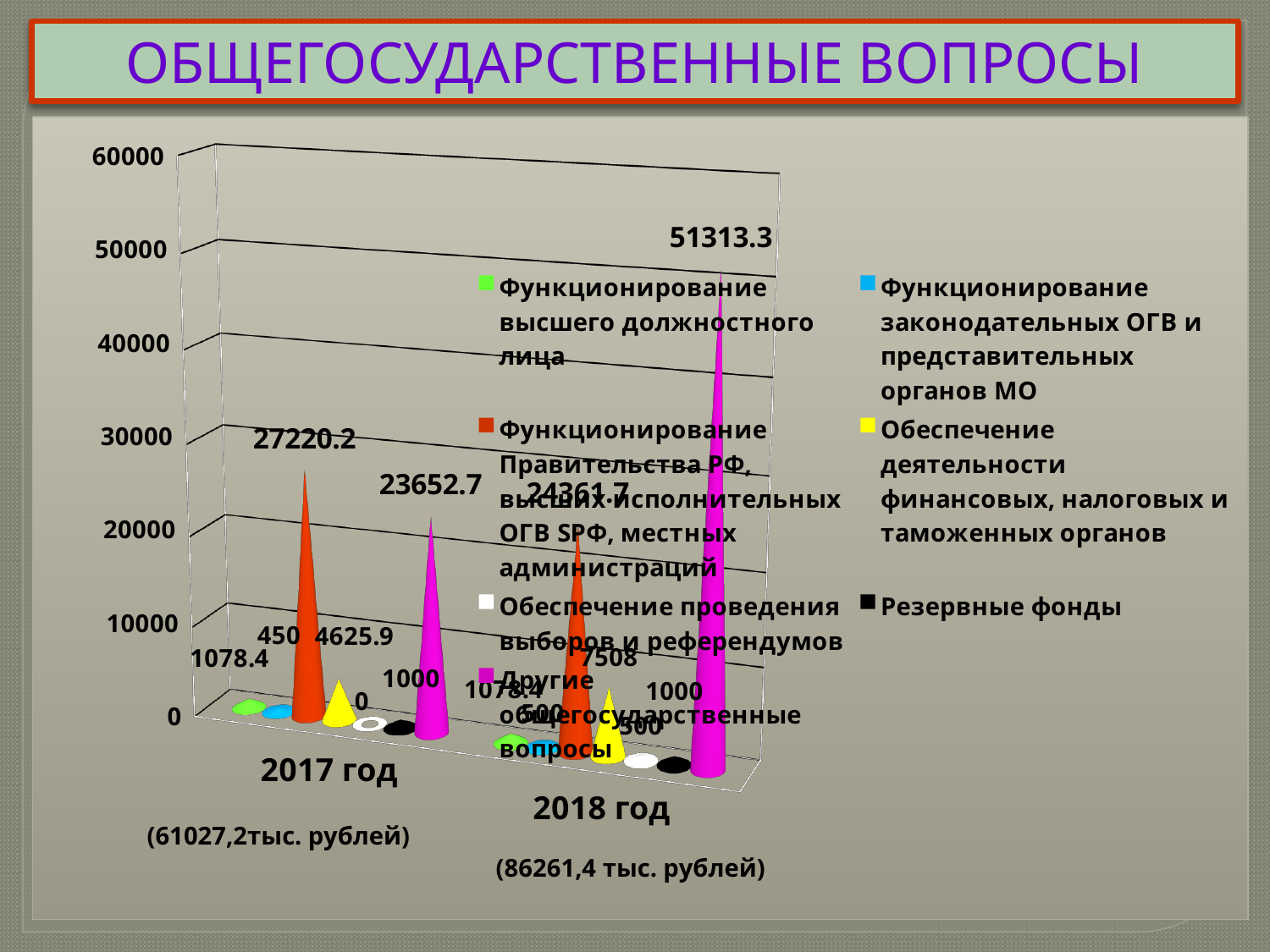
What total amount is printed under the 2017 год category? 61027,2 тыс. рублей What is the value for Функционирование Правительства РФ, высших исполнительных ОГВ SРФ, местных администраций in 2017 год? 27220.2 Which series has the highest value in 2018 год? Другие общегосударственные вопросы Is the value for Другие общегосударственные вопросы in 2018 год greater or less than 50000? greater What is the difference between the values for Другие общегосударственные вопросы in 2018 год and 2017 год? 27660.6 How many year categories are shown on the x axis? 2 What is the value for Обеспечение деятельности финансовых, налоговых и таможенных органов in 2018 год? 7508 How many series does the legend list? 7 Is the value for Функционирование Правительства РФ, высших исполнительных ОГВ SРФ, местных администраций larger in 2017 год or 2018 год? 2017 год What is the value for Другие общегосударственные вопросы in 2018 год? 51313.3 What is the value for Резервные фонды in 2017 год? 1000 What kind of chart is shown on the slide? bar chart